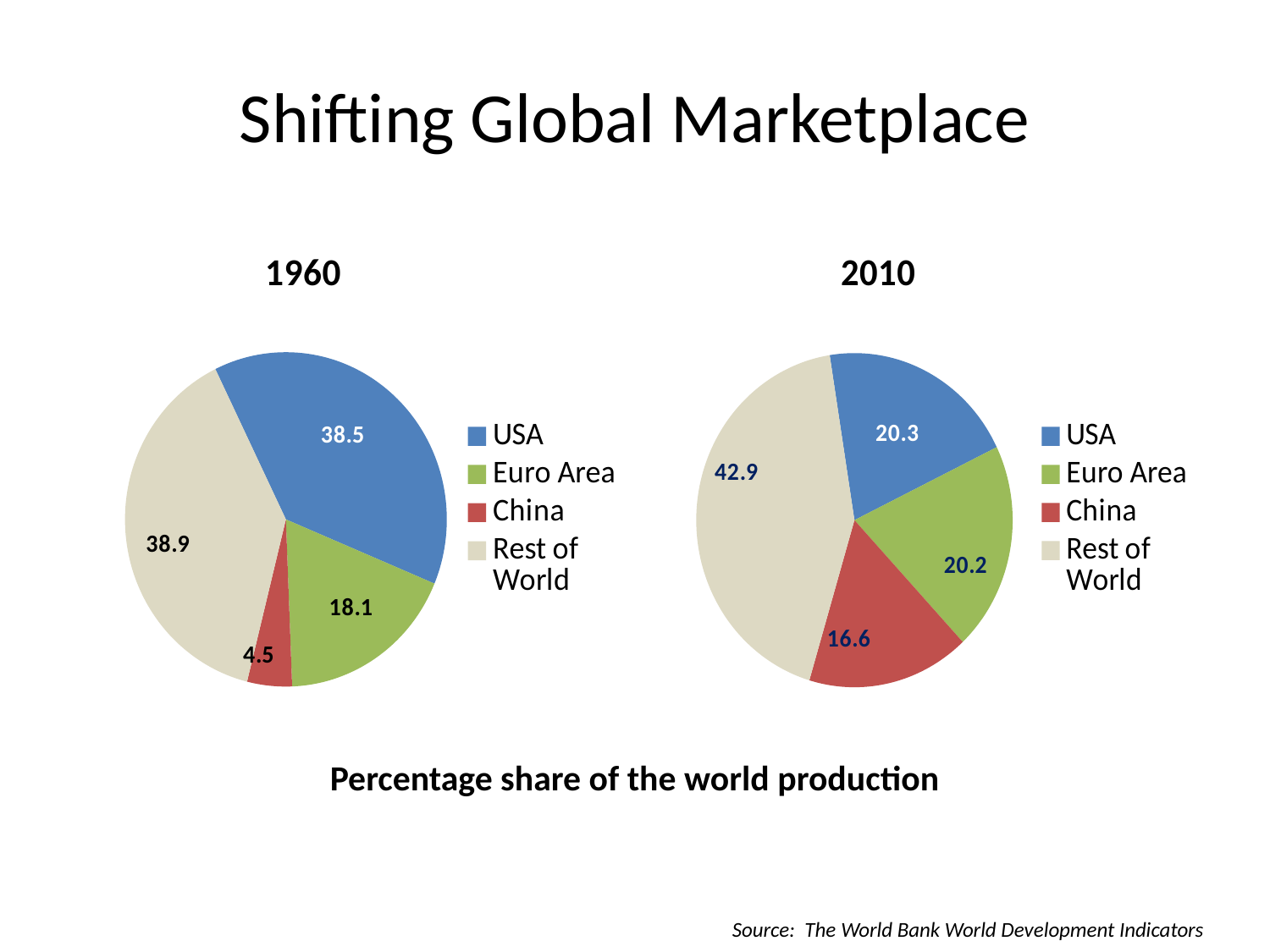
In the 1960 pie chart, what is the difference between the USA value and the Euro Area value? 20.4 In the 1960 pie chart, what is the value for USA? 38.5 In the 2010 pie chart, what is the value for China? 16.6 In the 2010 pie chart, which category has the smallest slice? China In the 2010 pie chart, what is the difference between the Rest of World value and the China value? 26.3 In the 1960 pie chart, which is larger, the value for Euro Area or the value for China? Euro Area How many slices does the 2010 pie chart have? 4 In the 2010 pie chart, which category has the largest slice? Rest of World In the 1960 pie chart, which category has the smallest slice? China What kind of chart is the 1960 chart? Pie chart In the 2010 pie chart, what is the value for Euro Area? 20.2 In the 2010 pie chart, what colour is the China slice? Red